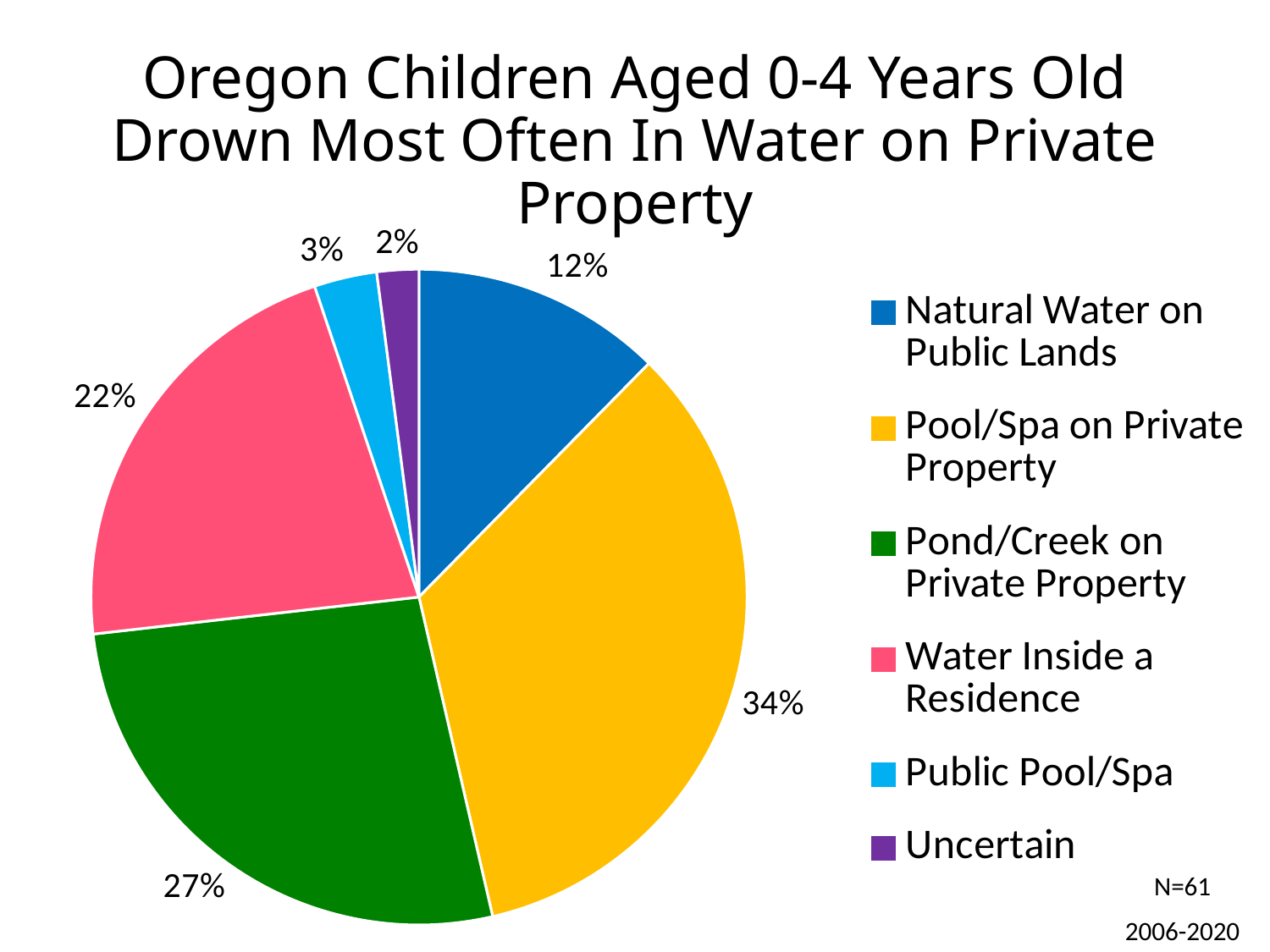
Which category has the smallest share of the pie? Uncertain How many categories does the pie chart show? 6 What share of drownings occurred in a Public Pool/Spa? 3% What share of drownings occurred in Water Inside a Residence? 22% What colour is the slice for Pond/Creek on Private Property? green Which is larger: the share for Water Inside a Residence or the share for Natural Water on Public Lands? Water Inside a Residence What share of drownings occurred in Natural Water on Public Lands? 12% What share of drownings occurred in a Pool/Spa on Private Property? 34% What is the difference in percentage points between Pool/Spa on Private Property and Pond/Creek on Private Property? 7 What type of chart is shown on the slide? pie chart Which category has the largest share of the pie? Pool/Spa on Private Property What is the combined share of Pool/Spa on Private Property and Pond/Creek on Private Property? 61%